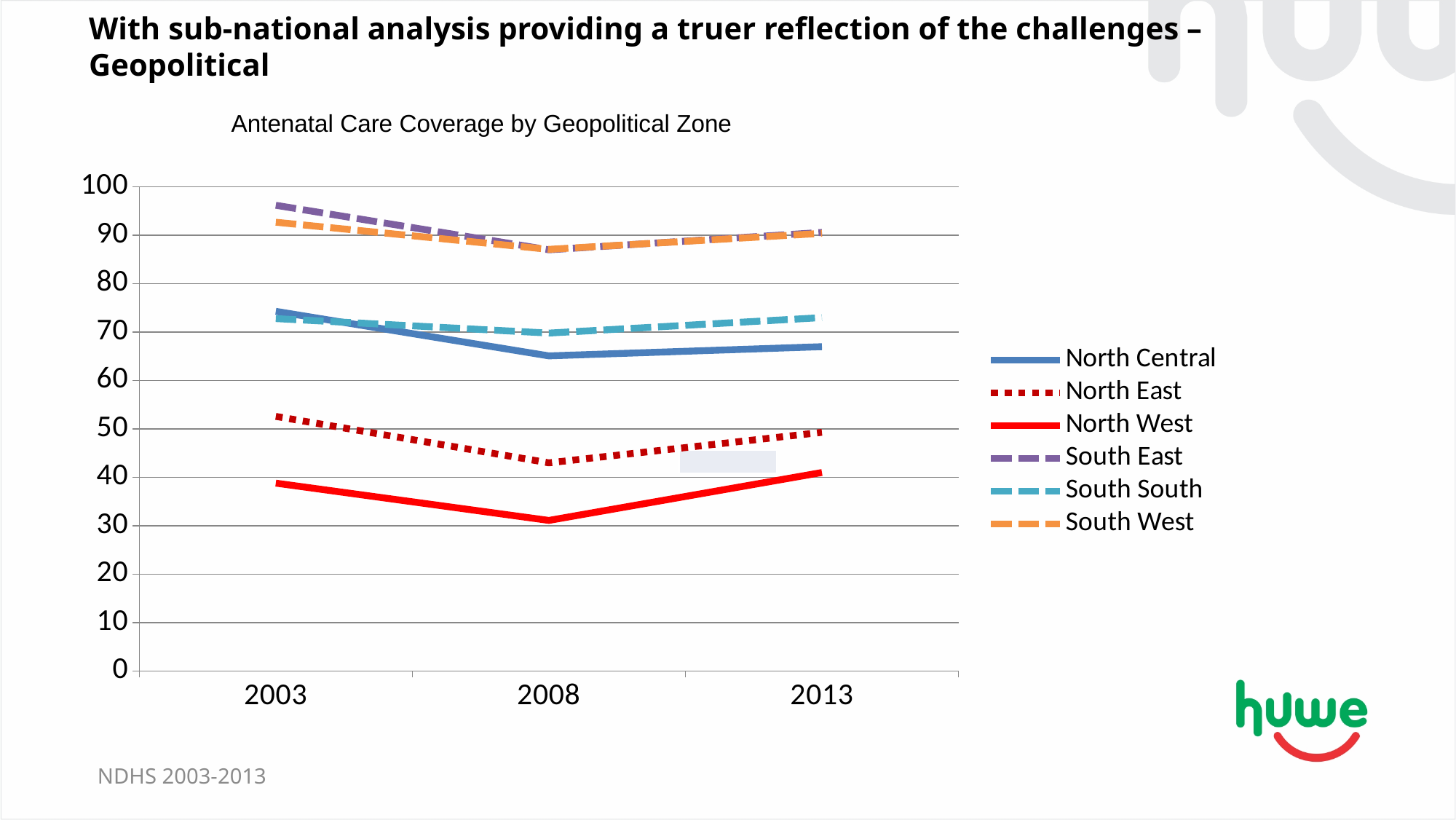
How many years are shown on the x axis? 3 What kind of chart is shown on the slide? line chart Which geopolitical zone has the lowest antenatal care coverage in 2008? North West In 2013, which is larger: North Central or South South? South South Does the North West line rise or fall from 2003 to 2008? fall Is the value for North West in 2008 greater or less than 40? less What is the title of the chart? Antenatal Care Coverage by Geopolitical Zone Is the value for North Central in 2013 greater or less than 70? less What data source is cited below the chart? NDHS 2003-2013 Which geopolitical zone has the highest antenatal care coverage in 2003? South East How many series does the legend list? 6 Is the value for South East in 2008 greater or less than 80? greater